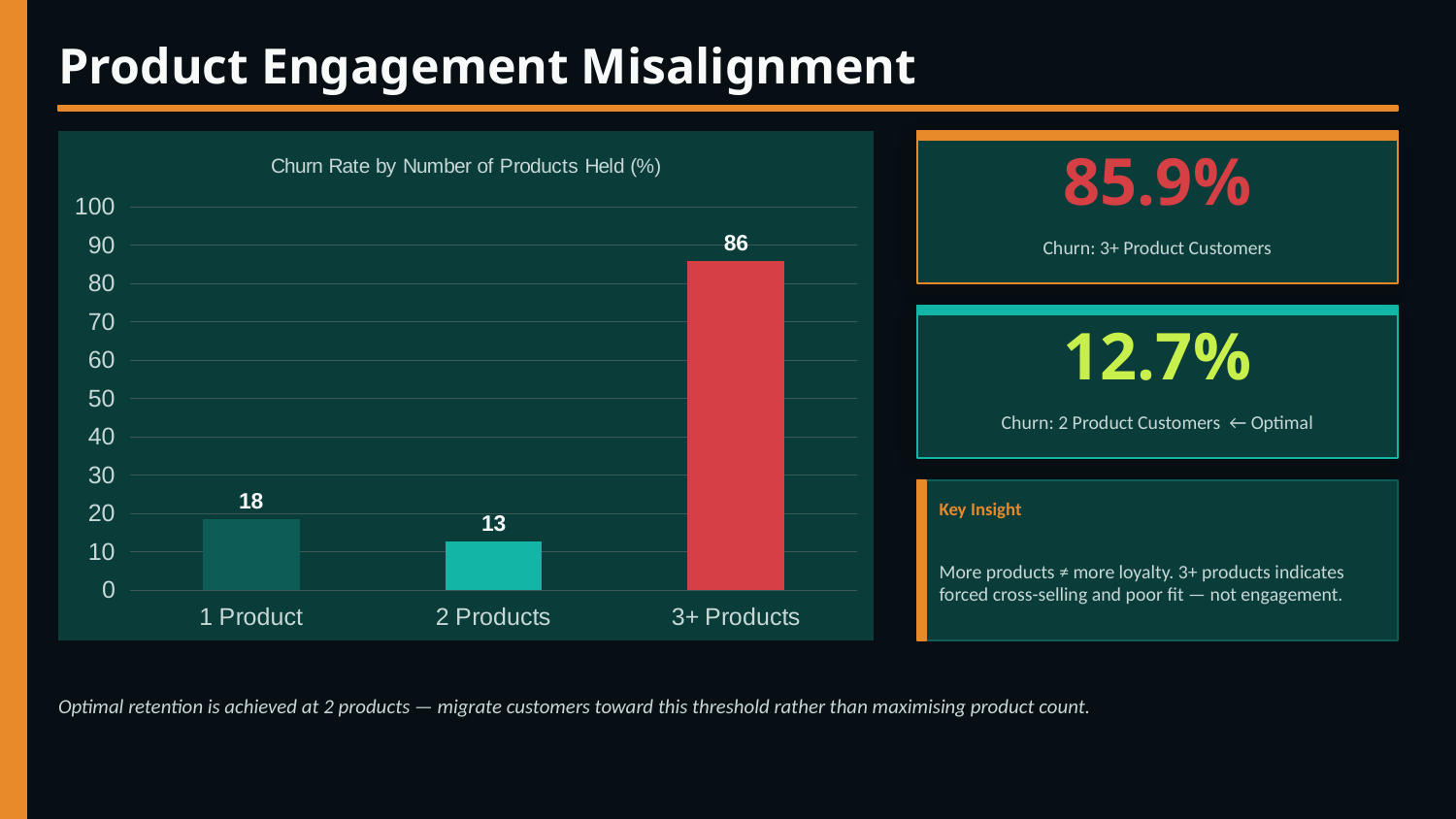
What type of chart is used to show churn rate by number of products held? Bar chart How many product-count categories are shown in the chart? 3 Is the churn rate for 3+ Products greater or less than 80? greater What is the churn rate for customers holding 2 Products? 13 What is the difference in churn rate between 3+ Products and 2 Products? 73 Which product-count category has the highest churn rate? 3+ Products Which has a higher churn rate, 1 Product or 2 Products? 1 Product What is the difference in churn rate between 1 Product and 2 Products? 5 What is the title of the chart? Churn Rate by Number of Products Held (%) What is the churn rate for customers holding 3+ Products? 86 What is the churn rate for customers holding 1 Product? 18 Which product-count category has the lowest churn rate? 2 Products